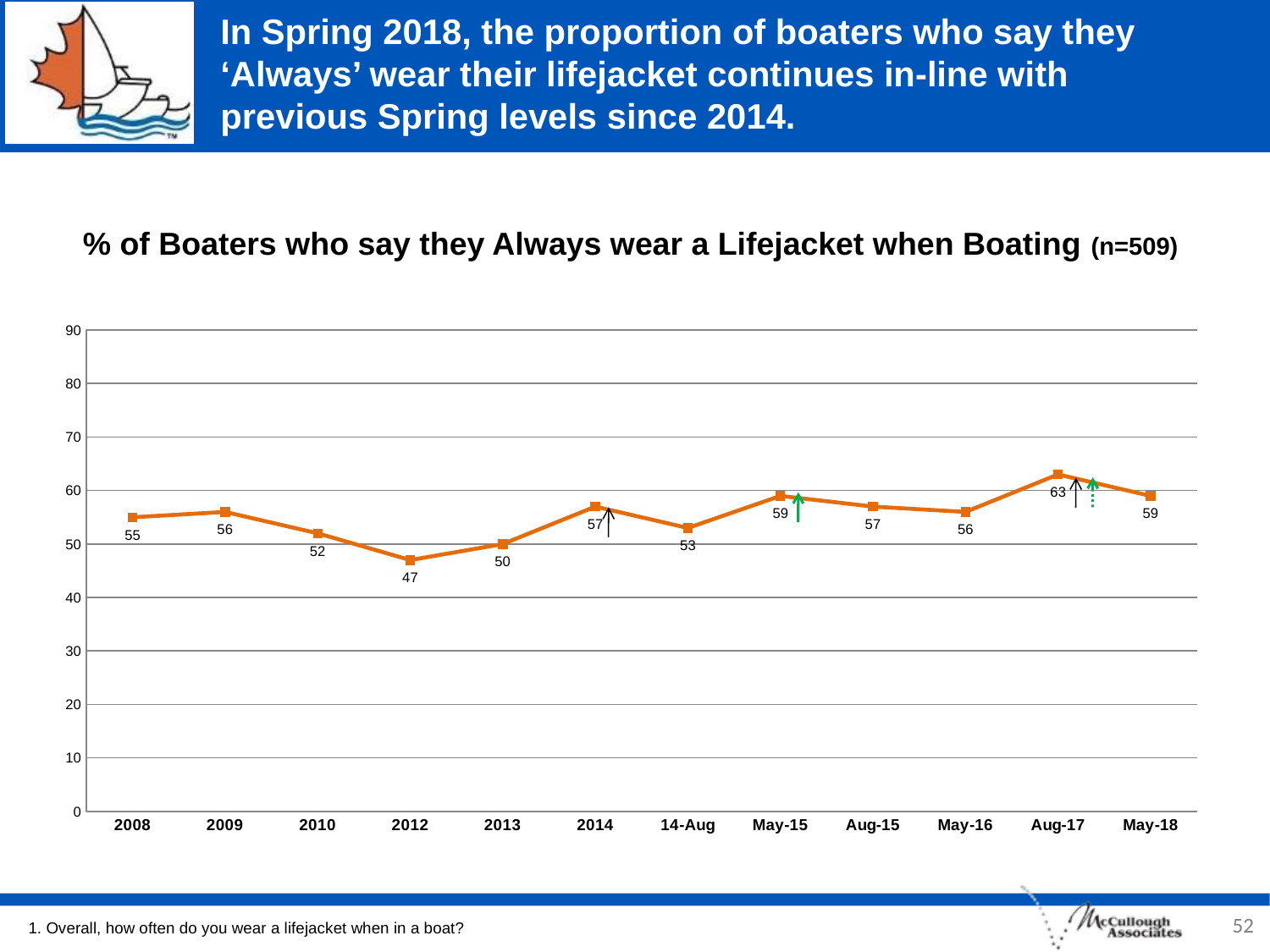
How many data points are plotted on the chart? 12 What kind of chart is shown on the slide? line chart What is the difference between the values for Aug-17 and May-18? 4 Which is larger, the value for 2010 or the value for 2014? 2014 Which category has the highest value? Aug-17 What is the sample size (n) shown in the chart title? n=509 What is the value for 14-Aug? 53 Which category has the lowest value? 2012 Is the value for 2013 greater or less than 60? less What is the value for May-18? 59 What is the value for Aug-17? 63 What is the value for 2012? 47